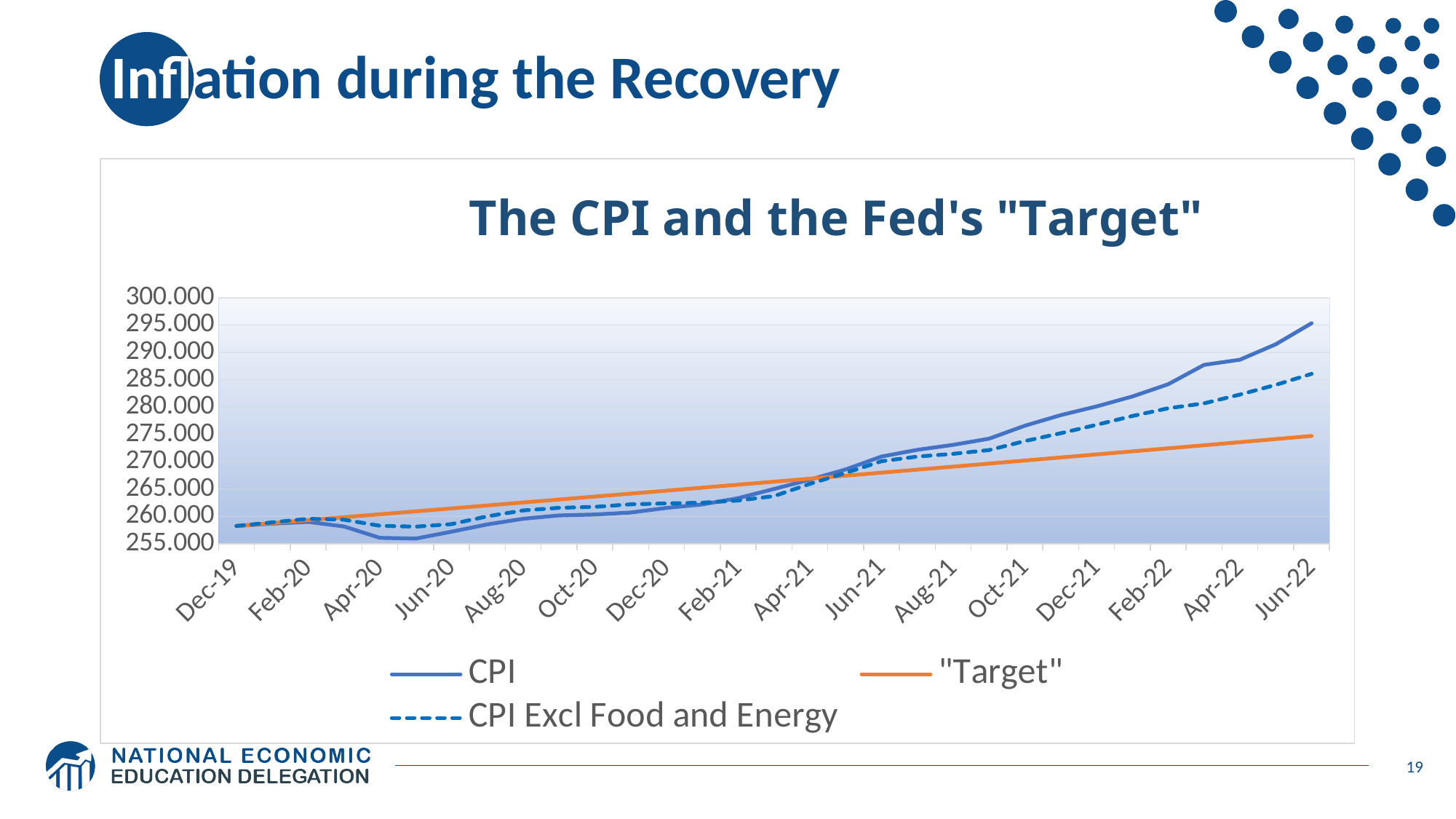
At Apr-20, which is higher: CPI or "Target"? "Target" How many series does the legend list? 3 Which series has the highest value at Jun-22? CPI Which series has the lowest value at Jun-22? "Target" Is the "Target" value at Jun-22 greater or less than 270.000? greater Is the CPI value at Jun-20 greater or less than 260.000? less At Jun-22, which is higher: CPI Excl Food and Energy or "Target"? CPI Excl Food and Energy Does the "Target" series rise or fall from Dec-19 to Jun-22? rise Is the CPI value at Jun-22 greater or less than 290.000? greater What kind of chart is shown on the slide? line chart What is the title of the chart? The CPI and the Fed's "Target" Which series is drawn with a dashed line? CPI Excl Food and Energy